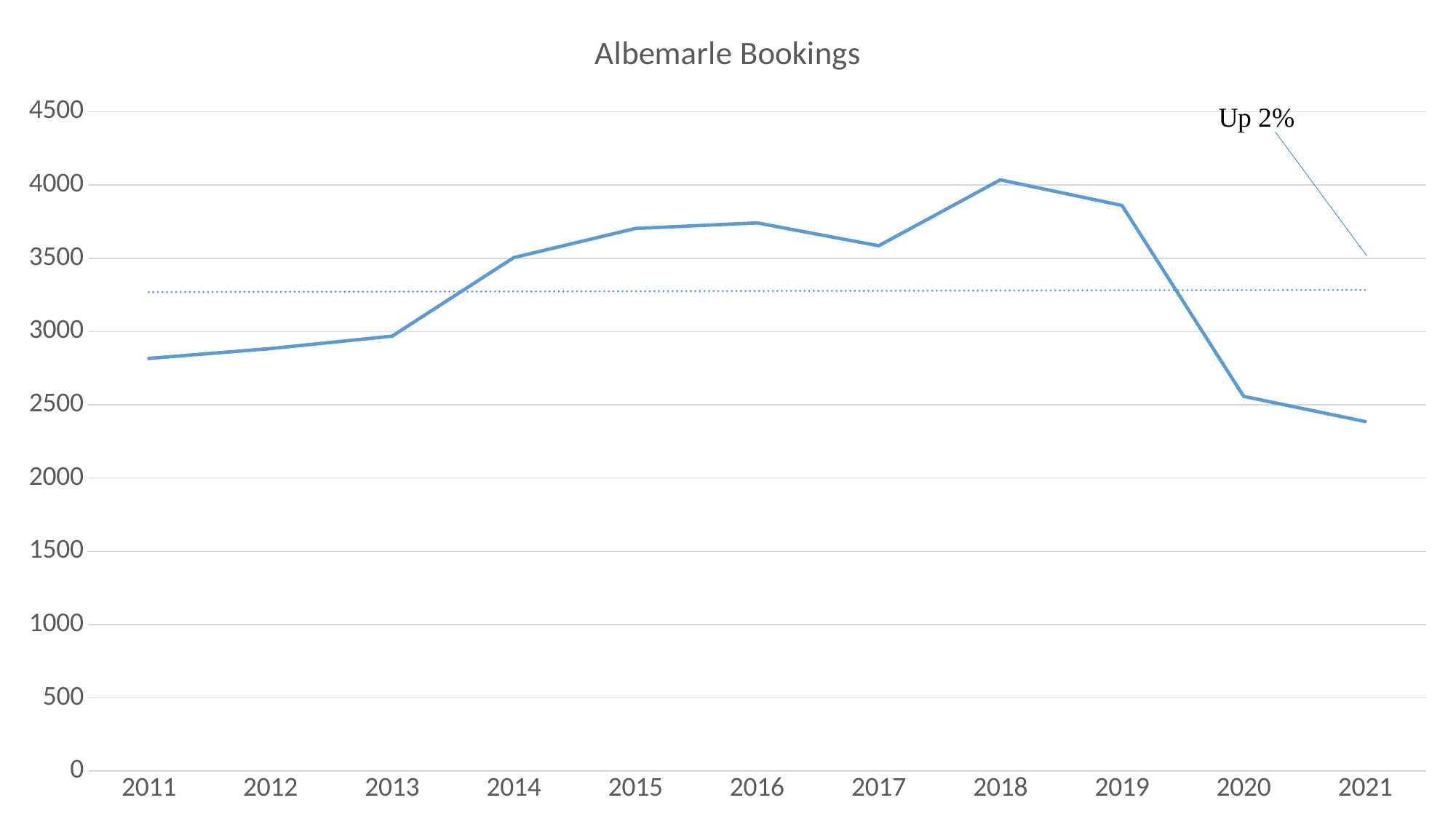
Is the value for 2019 greater or less than 3500? greater In which year were Albemarle bookings lowest? 2021 Is the value for 2018 greater or less than 3500? greater Which year has the larger value, 2019 or 2020? 2019 In which year were Albemarle bookings highest? 2018 What is the title of the chart? Albemarle Bookings How many years are plotted along the x axis? 11 Is the value for 2021 greater or less than 2500? less What kind of chart is shown on the slide? Line chart What text does the annotation near the top right of the chart say? Up 2% Do bookings rise or fall from 2019 to 2021? Fall